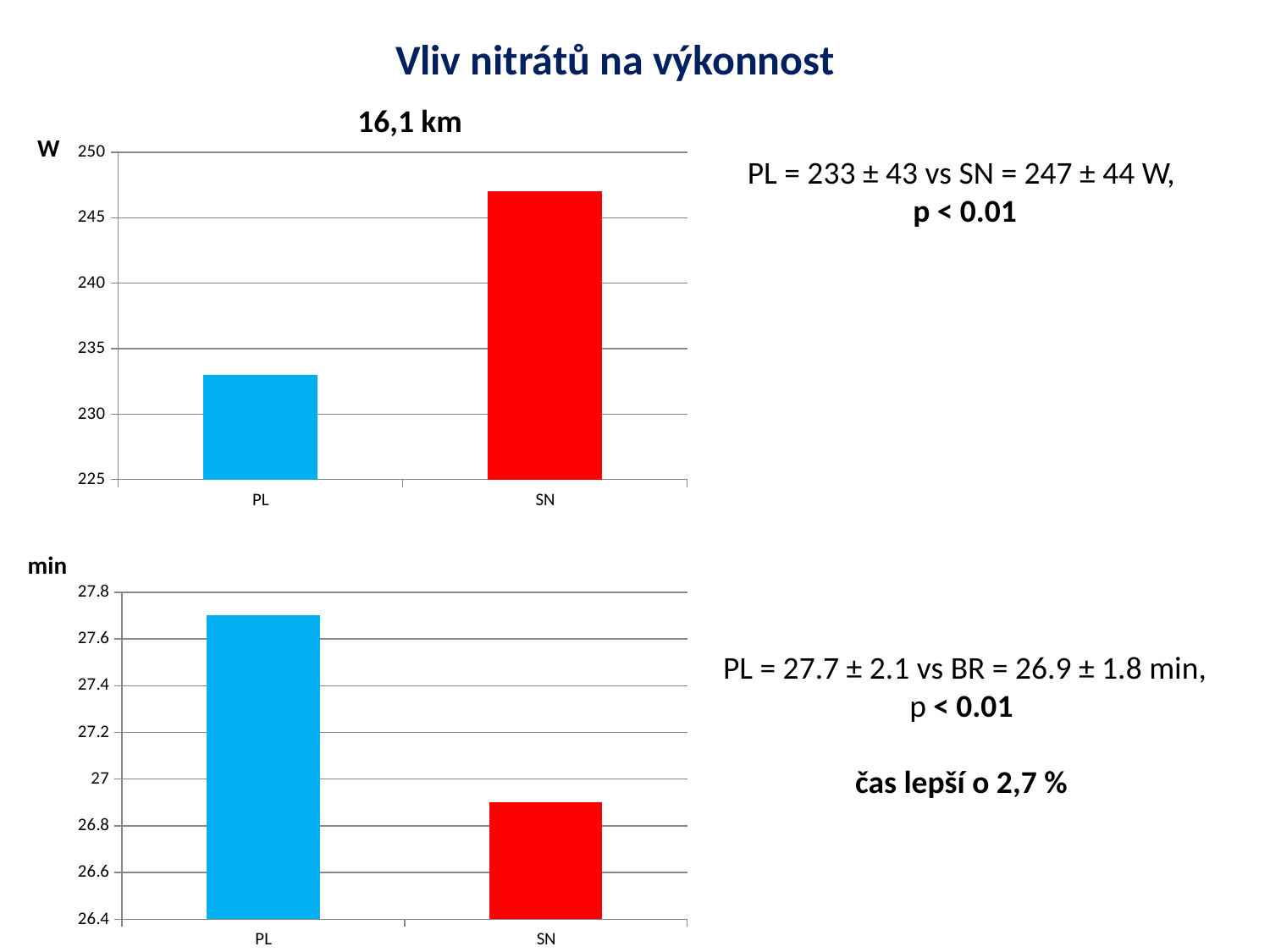
What colour is the PL bar in the bottom chart (min)? blue In the top chart titled "16,1 km", what is the value for PL in W according to the text on the slide? 233 In the top chart titled "16,1 km", which category has the higher value, PL or SN? SN In the bottom chart (min), which category has the lowest value? SN How many categories are shown in the top chart titled "16,1 km"? 2 In the bottom chart (min), what is the value for PL in minutes according to the text on the slide? 27.7 In the bottom chart (min), is the value for SN greater or less than 27? less In the top chart titled "16,1 km", what is the value for SN in W according to the text on the slide? 247 In the top chart titled "16,1 km", is the value for PL greater or less than 235? less In the bottom chart (min), is the value for PL greater or less than 27.6? greater What type of chart is the top chart titled "16,1 km"? bar chart